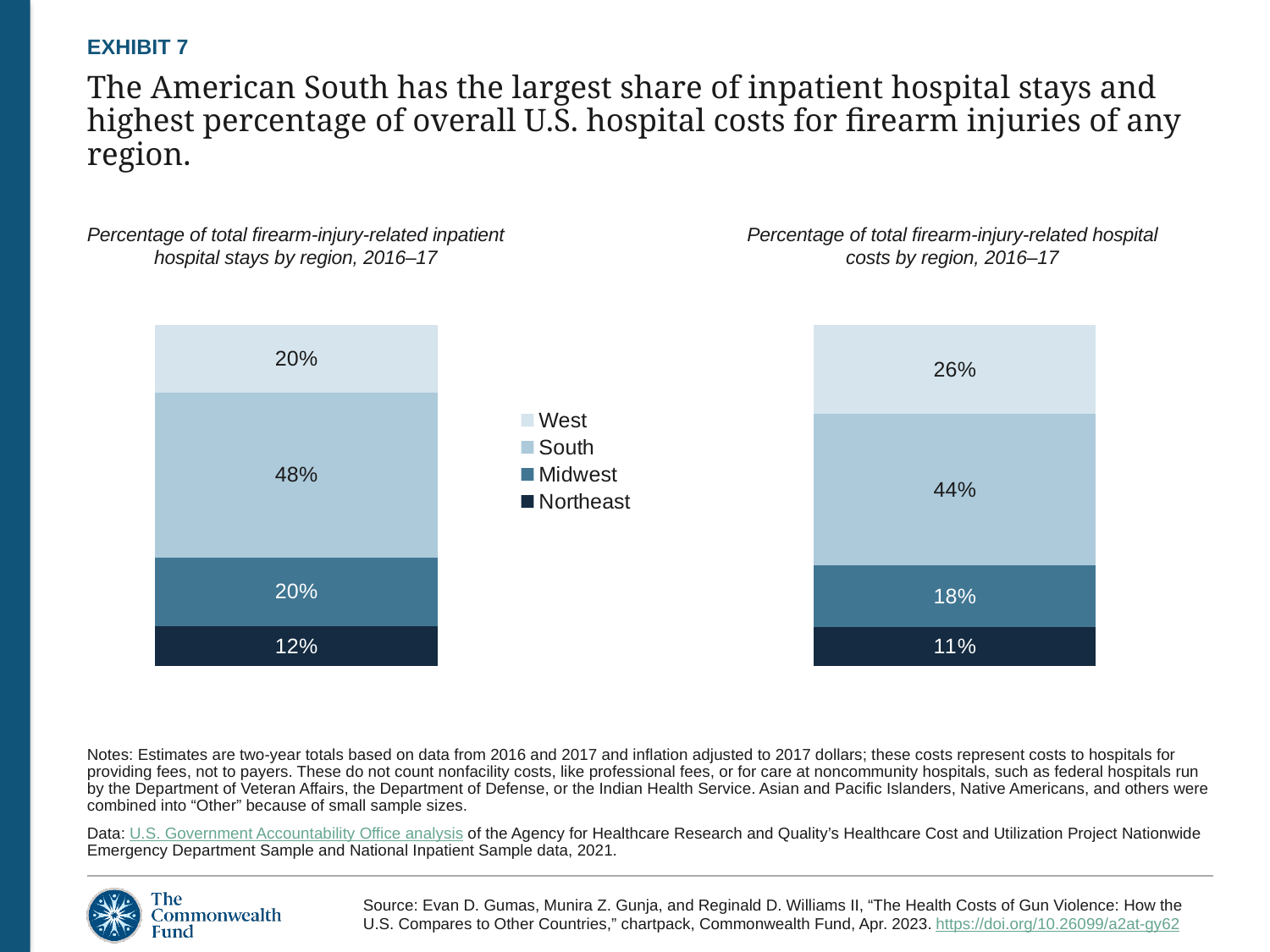
In the chart 'Percentage of total firearm-injury-related hospital costs by region, 2016–17', what is the difference between the South and the West? 18% What kind of chart is used on this slide? Stacked bar chart In the chart 'Percentage of total firearm-injury-related inpatient hospital stays by region, 2016–17', what is the value for the South? 48% Which region is shown in the darkest colour in the legend? Northeast In the chart 'Percentage of total firearm-injury-related hospital costs by region, 2016–17', what is the value for the West? 26% How many regions does the legend list? 4 Is the Midwest's share larger in the inpatient hospital stays chart or in the hospital costs chart? Inpatient hospital stays chart In the chart 'Percentage of total firearm-injury-related hospital costs by region, 2016–17', what is the value for the Northeast? 11% In the chart 'Percentage of total firearm-injury-related hospital costs by region, 2016–17', which region has the smallest share? Northeast In the chart 'Percentage of total firearm-injury-related inpatient hospital stays by region, 2016–17', what is the total of the stacked bar? 100% In the chart 'Percentage of total firearm-injury-related inpatient hospital stays by region, 2016–17', which region has the largest share? South In the chart 'Percentage of total firearm-injury-related inpatient hospital stays by region, 2016–17', what is the difference between the South and the Northeast? 36%